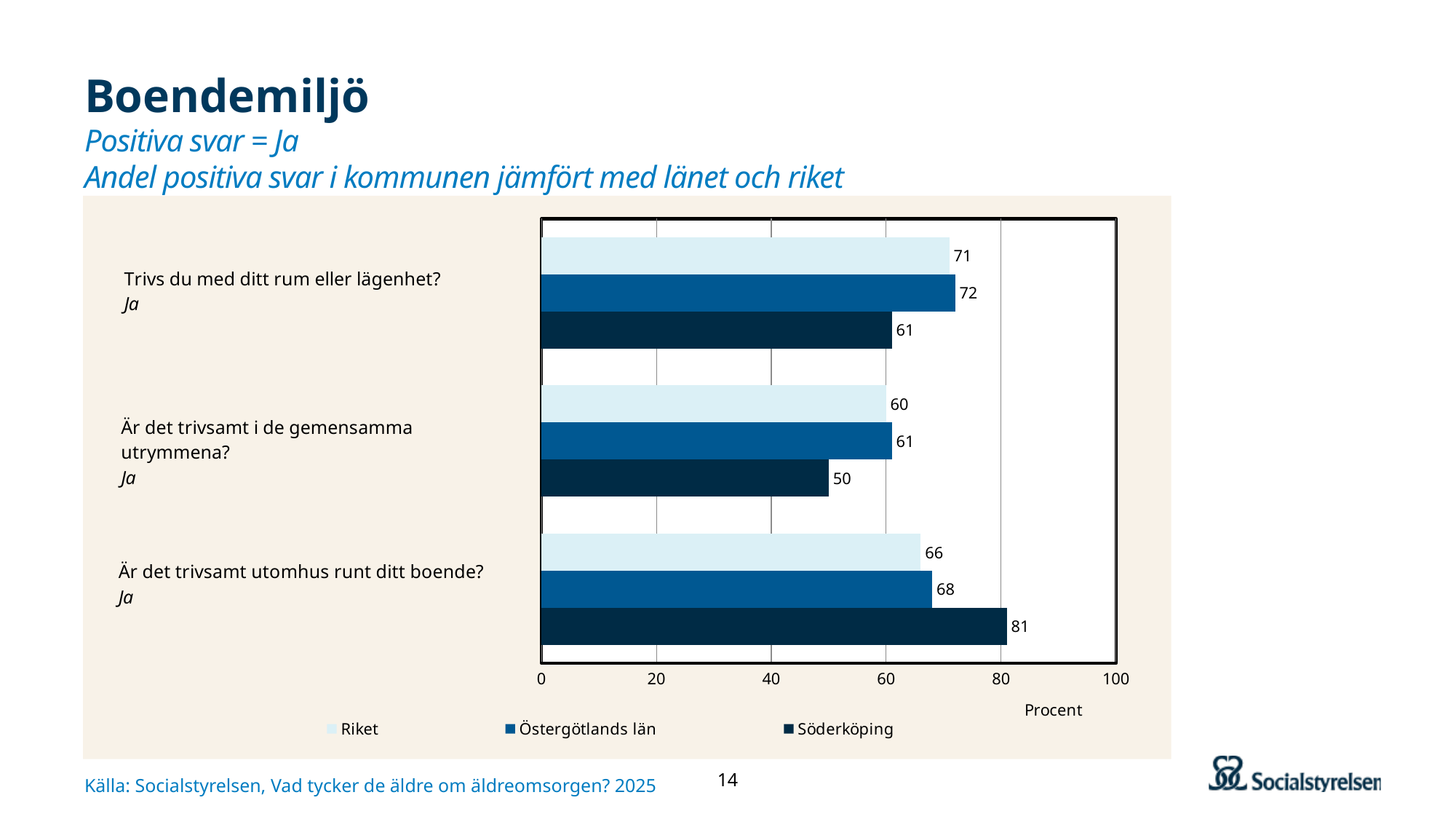
For "Är det trivsamt i de gemensamma utrymmena?", which is larger: Riket or Söderköping? Riket Which question has the highest value for Söderköping? Är det trivsamt utomhus runt ditt boende? What is the difference between Östergötlands län and Söderköping for "Trivs du med ditt rum eller lägenhet?"? 11 What is the value for Riket for "Är det trivsamt i de gemensamma utrymmena?"? 60 Is the value for Söderköping for "Är det trivsamt utomhus runt ditt boende?" greater or less than 80? greater What is the value for Söderköping for "Trivs du med ditt rum eller lägenhet?"? 61 How many questions (categories) are shown in the chart? 3 Which question has the lowest value for Söderköping? Är det trivsamt i de gemensamma utrymmena? How many series does the legend list? 3 What is the value for Östergötlands län for "Är det trivsamt utomhus runt ditt boende?"? 68 What is the difference between Söderköping and Riket for "Är det trivsamt utomhus runt ditt boende?"? 15 What kind of chart is shown on the slide? Bar chart